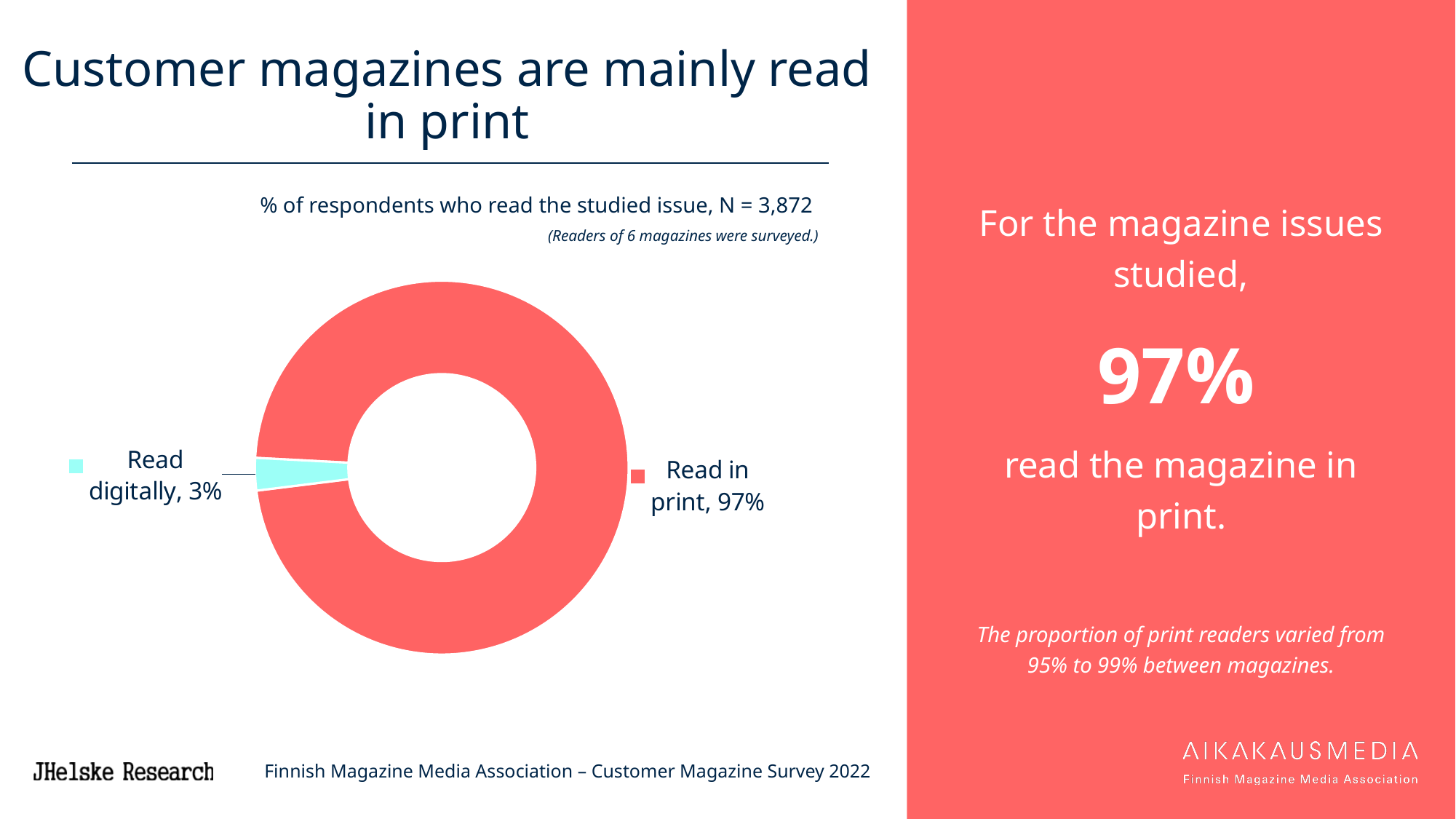
What kind of chart is shown on the slide? Doughnut (pie) chart What share of the chart does the 'Read digitally' slice represent? 3% What is the sample size (N) stated in the chart subtitle? 3,872 Which category has the smallest share of the chart? Read digitally What is the difference in percentage points between those who read in print and those who read digitally? 94 What colour is the 'Read in print' slice? Red (coral) Which category has the largest share of the chart? Read in print How many categories are shown in the chart? 2 What percentage of respondents read the magazine digitally? 3% Which is larger: the share who read in print or the share who read digitally? Read in print What percentage of respondents read the magazine in print? 97%